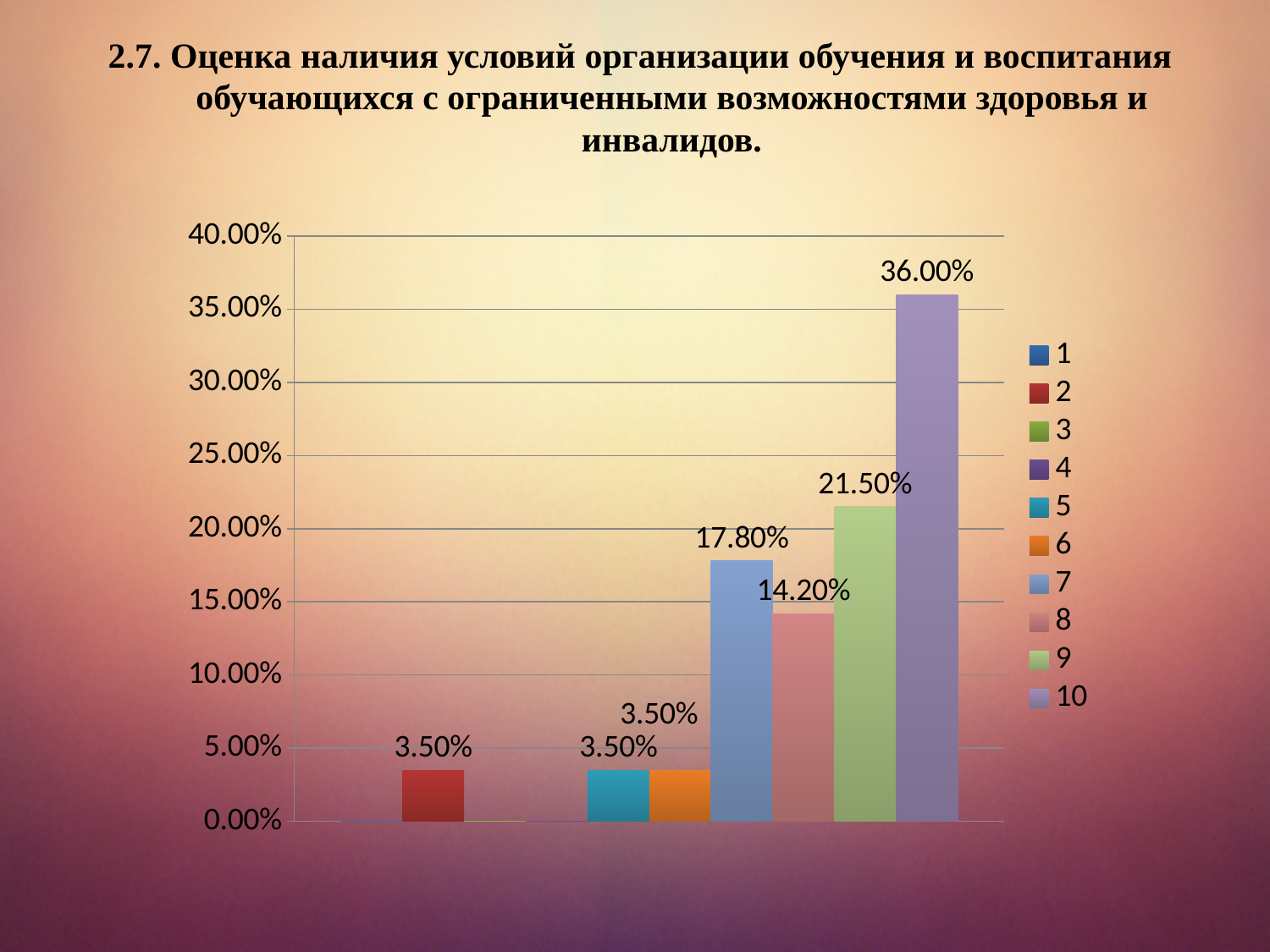
What is the difference between the values for series 10 and series 9? 14.50% How many series does the legend list? 10 What is the value for series 9? 21.50% What is the value for series 2? 3.50% Which is larger, the value for series 7 or the value for series 8? series 7 Is the value for series 10 greater or less than 35.00%? greater What is the value for series 10? 36.00% What is the value for series 8? 14.20% Which series has the highest value? 10 What is the value for series 7? 17.80% What is the difference between the values for series 7 and series 8? 3.60% What kind of chart is shown on the slide? bar chart